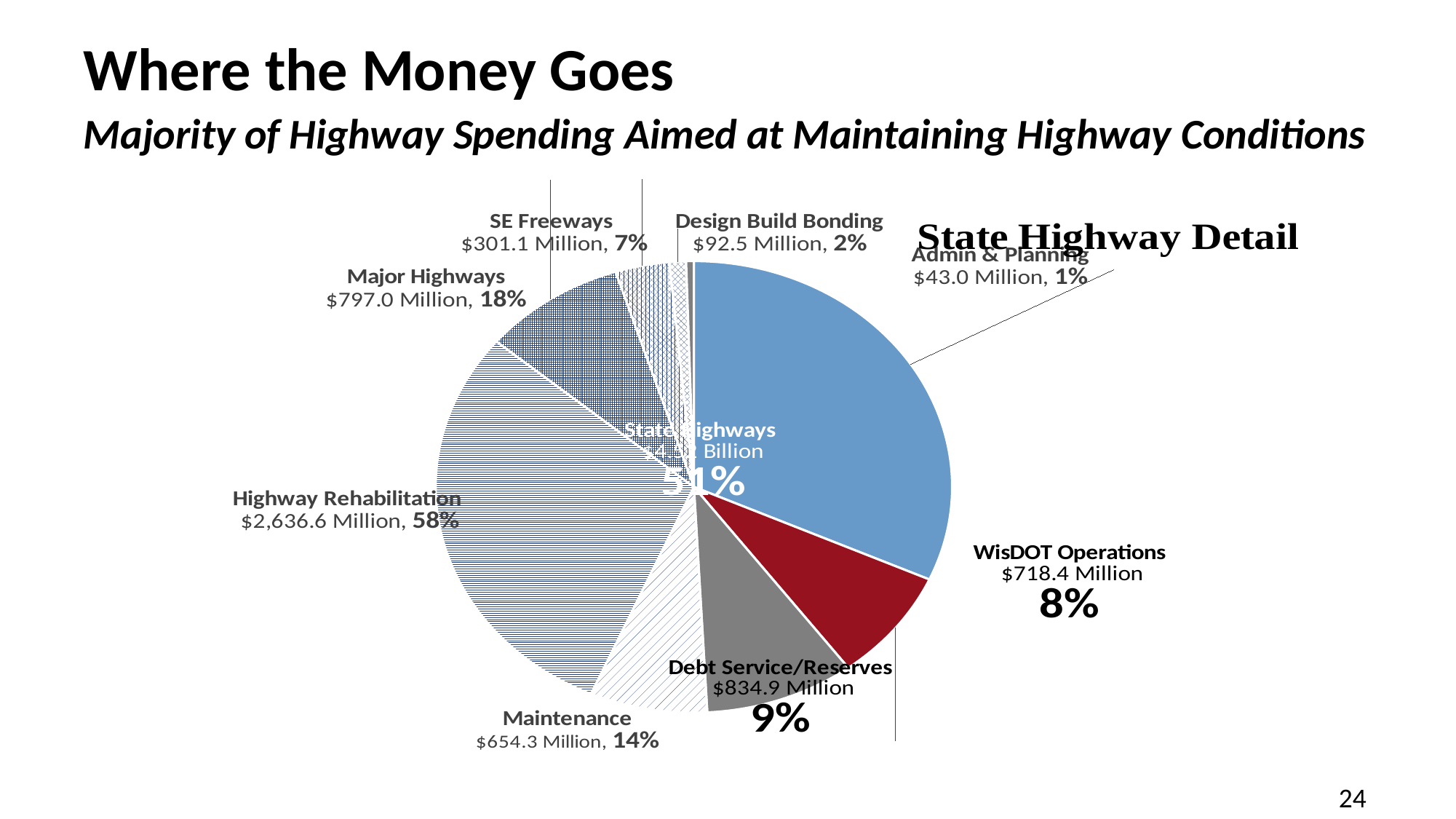
How much money goes to WisDOT Operations? $718.4 Million What kind of chart is shown on the slide? pie chart In the State Highway Detail, which category has the smallest share? Admin & Planning What share of the pie does State Highways represent? 51% Which receives more money, Major Highways or SE Freeways? Major Highways In the State Highway Detail, which category has the largest share? Highway Rehabilitation What percentage of the pie is Debt Service/Reserves? 9% How much is allocated to Design Build Bonding? $92.5 Million In the State Highway Detail, how much is spent on Highway Rehabilitation? $2,636.6 Million In the State Highway Detail, what percentage is Maintenance? 14% What is the main title of the slide? Where the Money Goes How much more is spent on Debt Service/Reserves than on WisDOT Operations? $116.5 Million